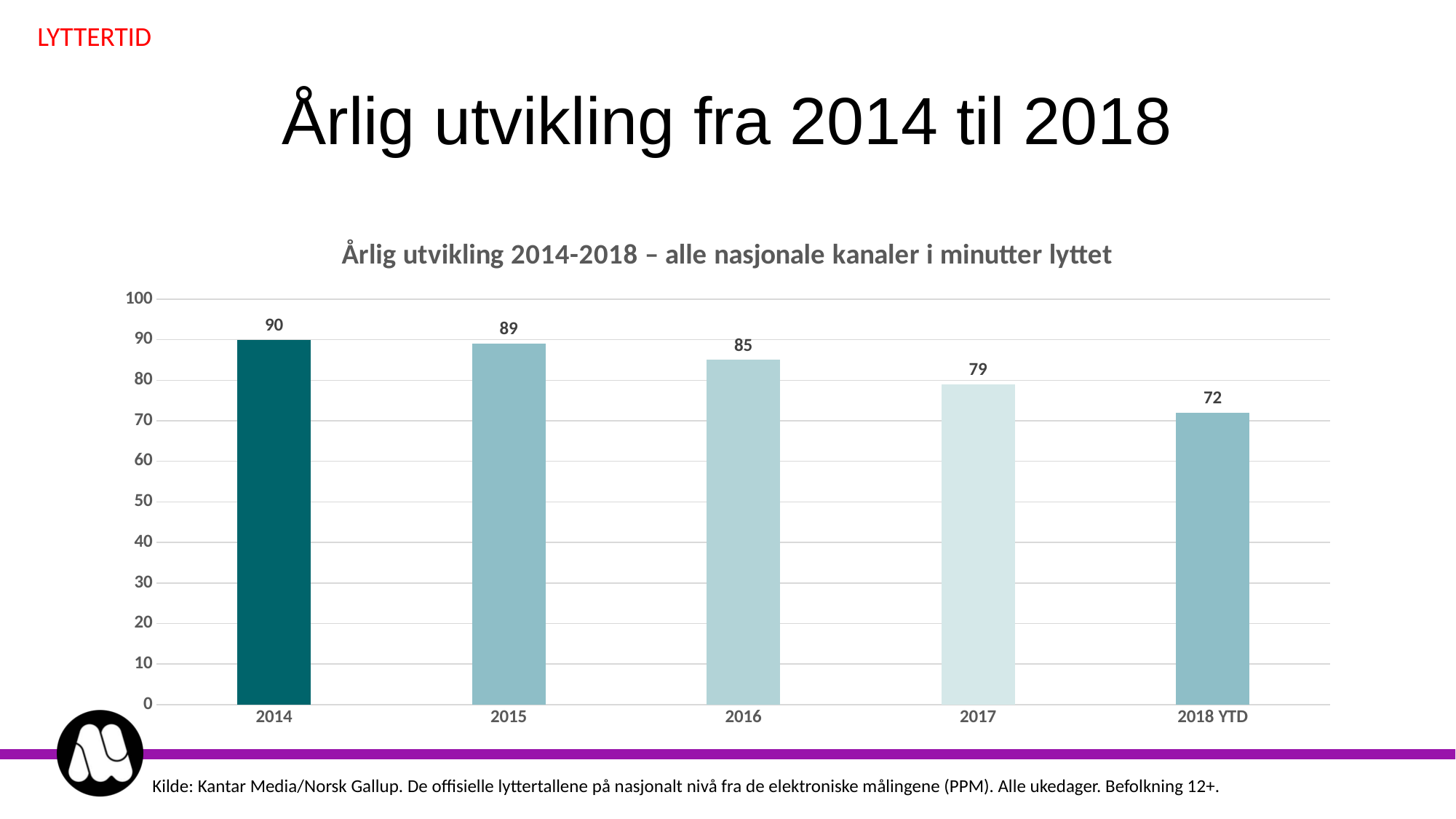
Do the values rise or fall from 2014 to 2018 YTD? fall What is the difference between the values for 2014 and 2018 YTD? 18 Which is larger, the value for 2015 or the value for 2017? 2015 Which category has the lowest value? 2018 YTD What is the value for 2014? 90 Is the value for 2017 greater or less than 80? less How many categories are shown on the x axis? 5 Which year has the highest value? 2014 What kind of chart is shown on the slide? bar chart What is the value for 2018 YTD? 72 What is the value for 2016? 85 What is the difference between the values for 2016 and 2017? 6